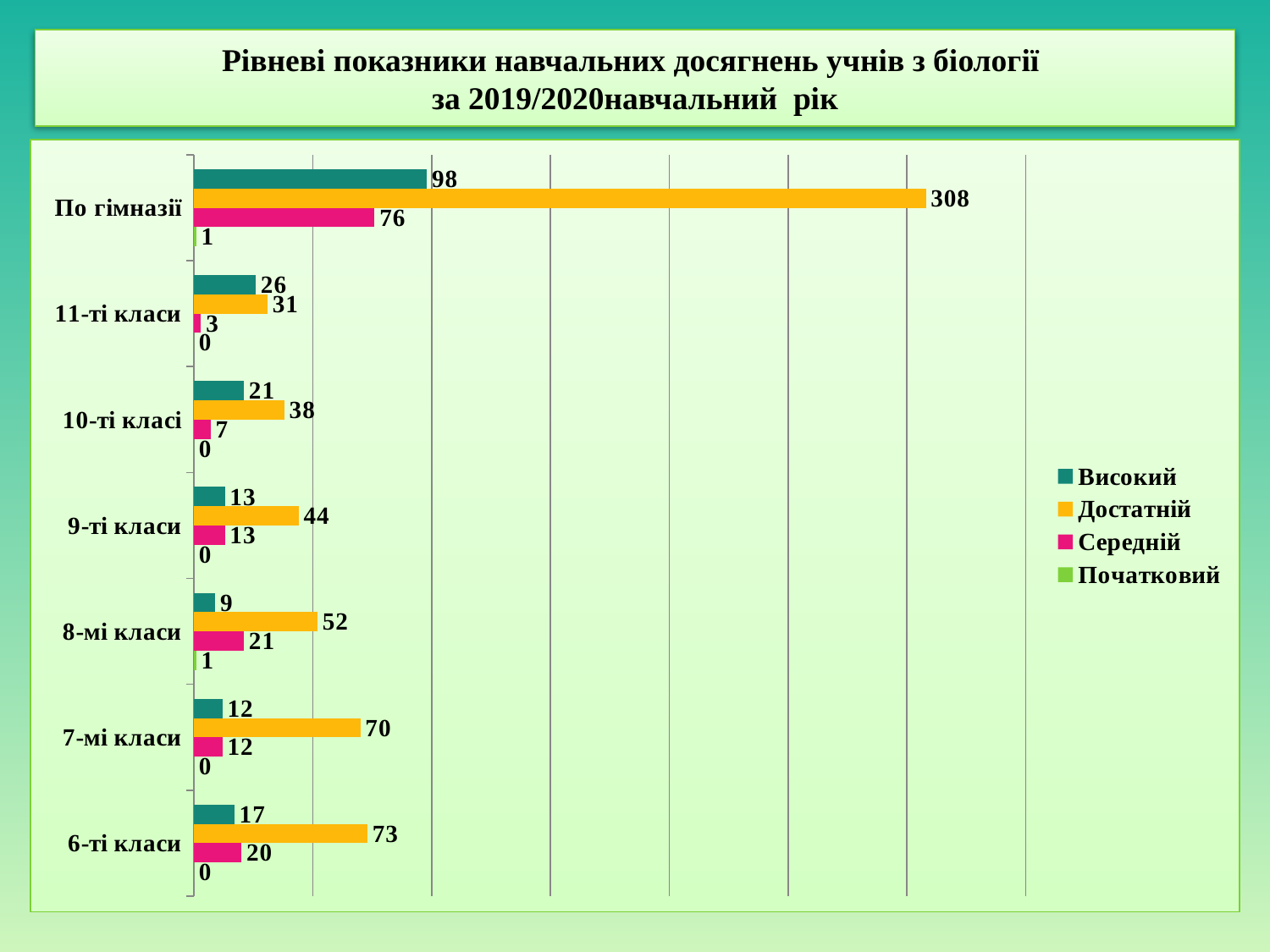
Which is larger: Високий for 10-ті класі or Високий for 6-ті класи? 10-ті класі Which colour represents the Початковий series in the legend? Green What is the value of Достатній for По гімназії? 308 What is the difference between the Достатній values for 7-мі класи and 9-ті класи? 26 Which class group has the lowest Високий value? 8-мі класи What kind of chart is shown on the slide? Bar chart How many class categories are shown on the chart? 7 What is the value of Високий for 11-ті класи? 26 Which class group has the highest Достатній value, excluding По гімназії? 6-ті класи What is the value of Середній for 8-мі класи? 21 How many series does the legend list? 4 What is the value of Достатній for 6-ті класи? 73